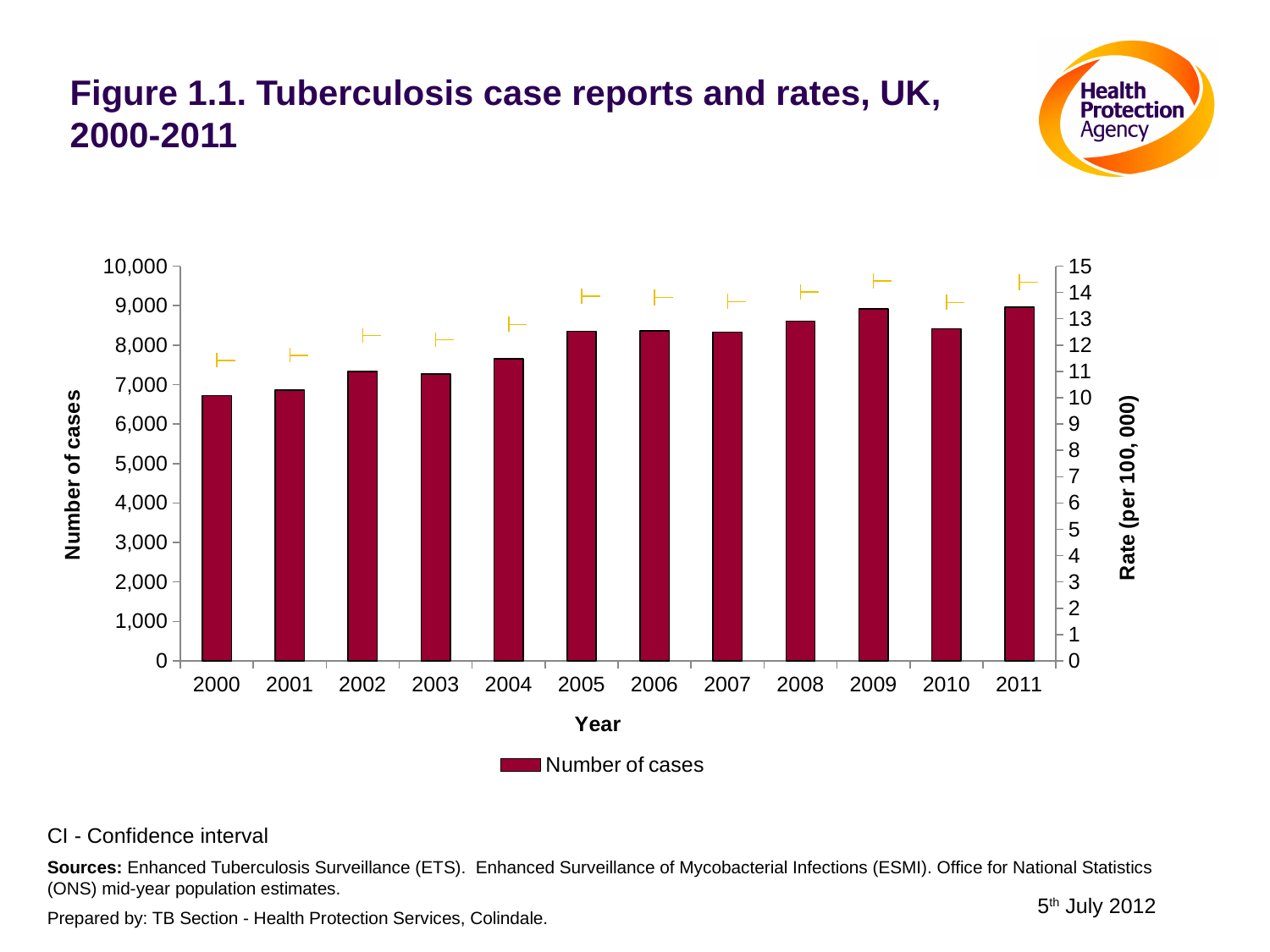
How many series does the chart's legend list? 1 Is the number of cases for 2000 greater or less than 7,000? less Overall, does the number of cases rise or fall from 2000 to 2011? Rise What is the title of the right-hand vertical axis of the chart? Rate (per 100, 000) Which year has the larger number of cases, 2002 or 2005? 2005 Is the number of cases for 2005 greater or less than 8,000? greater Is the number of cases for 2004 greater or less than 8,000? less Which year has the larger number of cases, 2000 or 2011? 2011 What kind of chart is shown on the slide? Bar chart How many years are shown along the x axis of the chart? 12